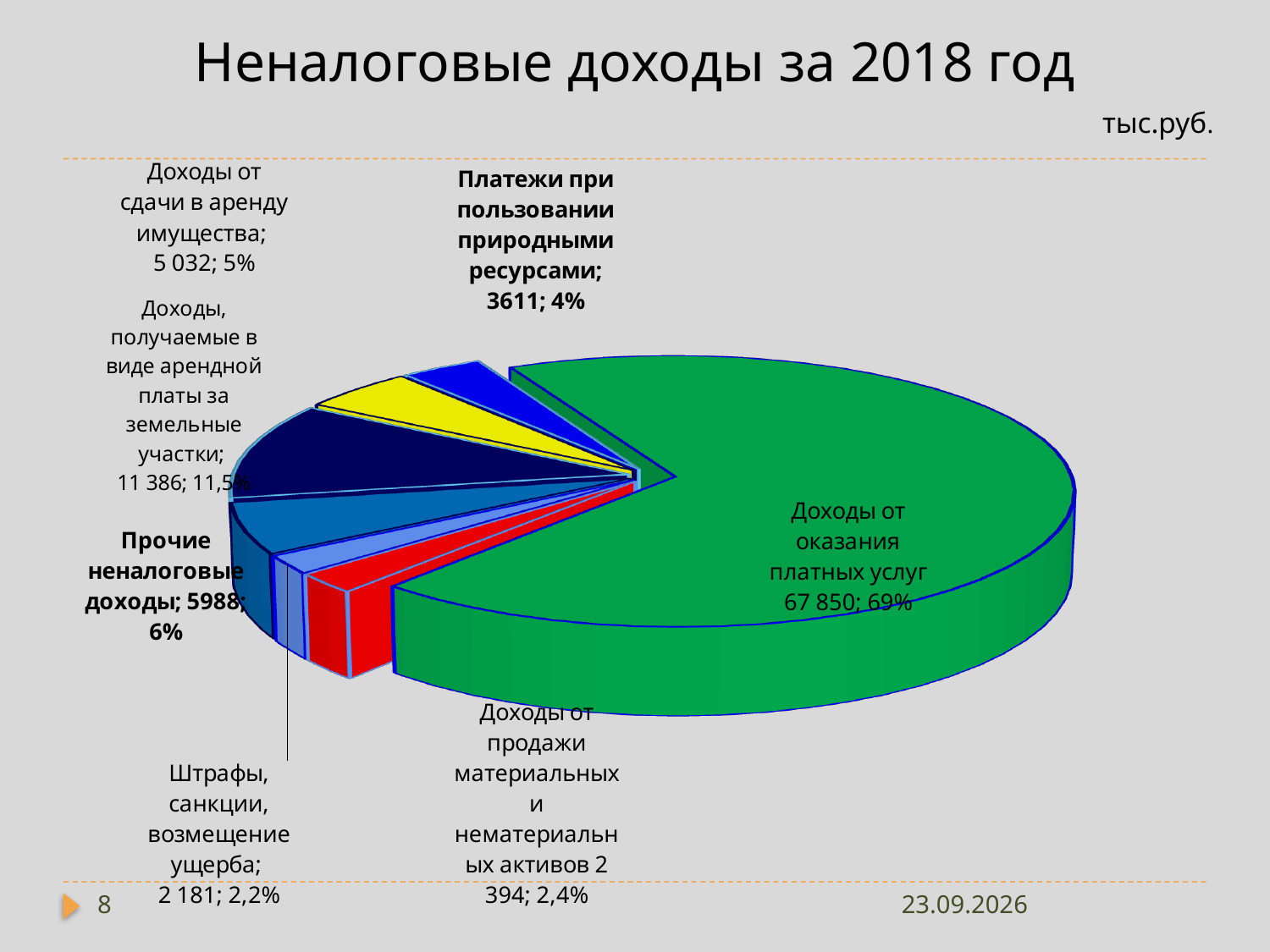
What is the value for Платежи при пользовании природными ресурсами? 3611 What kind of chart is shown on the slide? pie chart How many categories are shown in the pie chart? 7 What is the value for Доходы от оказания платных услуг? 67 850 Which category has the smallest slice of the pie? Штрафы, санкции, возмещение ущерба Which category has the largest slice of the pie? Доходы от оказания платных услуг What share of the pie does Прочие неналоговые доходы represent? 6% What is the difference between the values for Доходы от оказания платных услуг and Доходы, получаемые в виде арендной платы за земельные участки? 56 464 What share of the pie does Доходы от сдачи в аренду имущества represent? 5% What is the value for Штрафы, санкции, возмещение ущерба? 2 181 What is the value for Доходы, получаемые в виде арендной платы за земельные участки? 11 386 Which is larger: Прочие неналоговые доходы or Доходы от сдачи в аренду имущества? Прочие неналоговые доходы